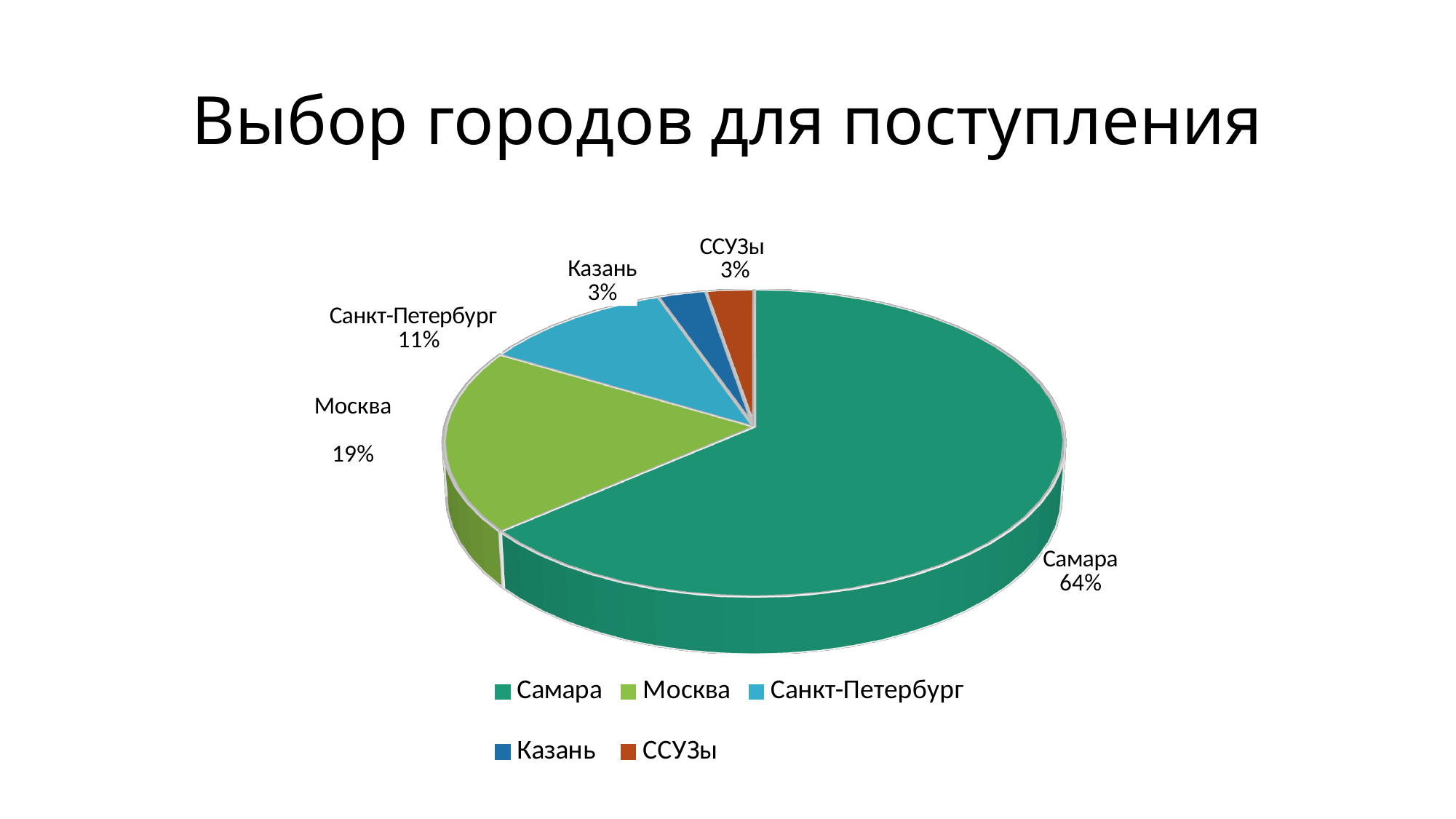
What share of the pie does Самара have? 64% What share of the pie does Москва have? 19% What is the difference in percentage points between Москва and Санкт-Петербург? 8 How many entries does the legend list? 5 What kind of chart is shown on the slide? pie chart Which category has the largest slice of the pie? Самара What is the title of the slide? Выбор городов для поступления Which is larger, the slice for Москва or the slice for Санкт-Петербург? Москва What share of the pie does Санкт-Петербург have? 11% How many slices does the pie chart have? 5 What is the difference in percentage points between Самара and Москва? 45